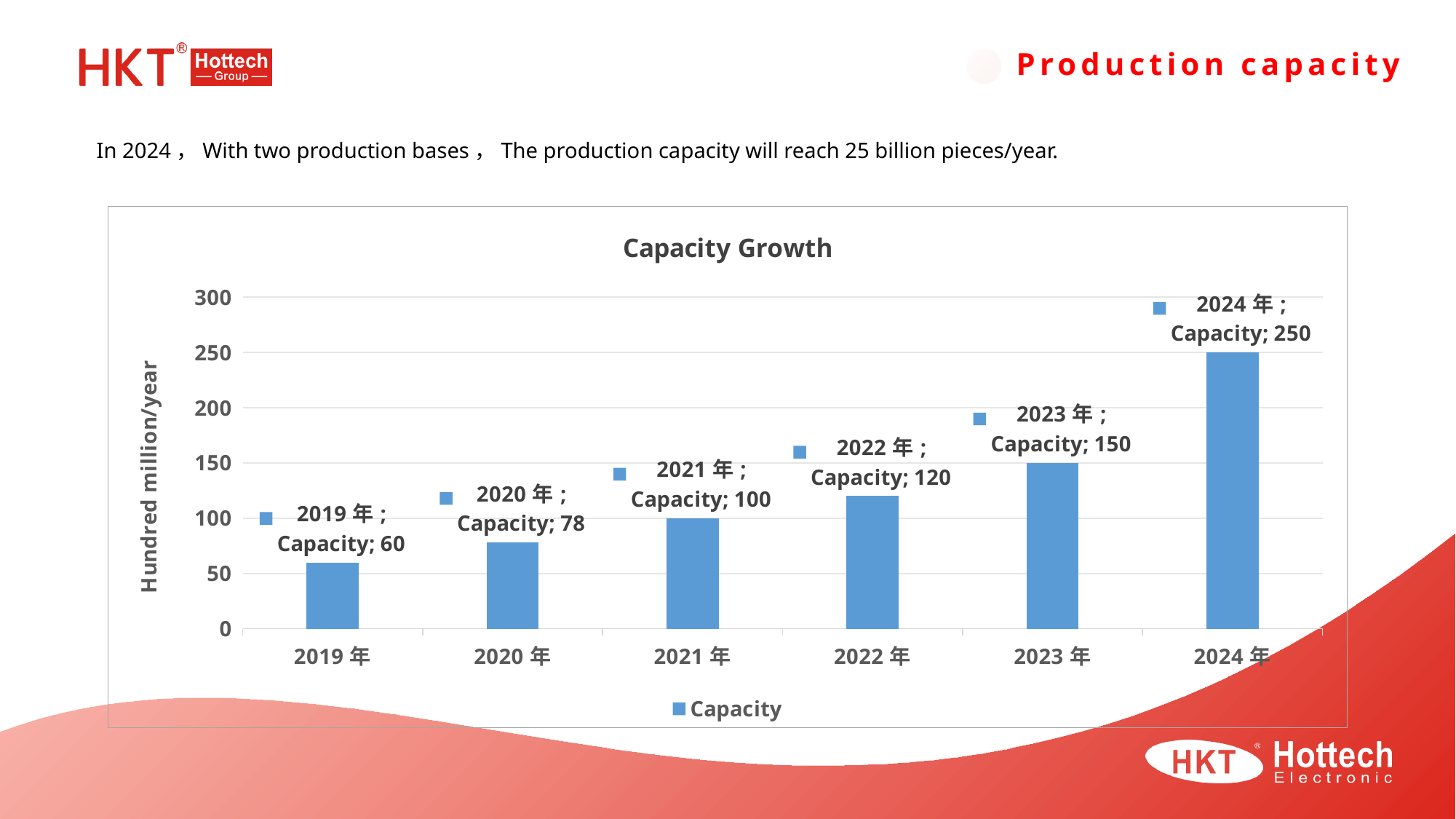
What kind of chart is shown on the slide? Bar chart How many series does the legend list? 1 What is the capacity value for 2021 年 in the Capacity Growth chart? 100 What is the capacity value for 2024 年? 250 Which has a larger capacity, 2022 年 or 2021 年? 2022 年 What is the difference in capacity between 2024 年 and 2023 年? 100 What is the capacity value for 2019 年? 60 Which year has the lowest capacity? 2019 年 Do the capacity values rise or fall from 2019 年 to 2024 年? Rise Which year has the highest capacity? 2024 年 What is the difference in capacity between 2020 年 and 2019 年? 18 How many years are shown on the x axis of the chart? 6